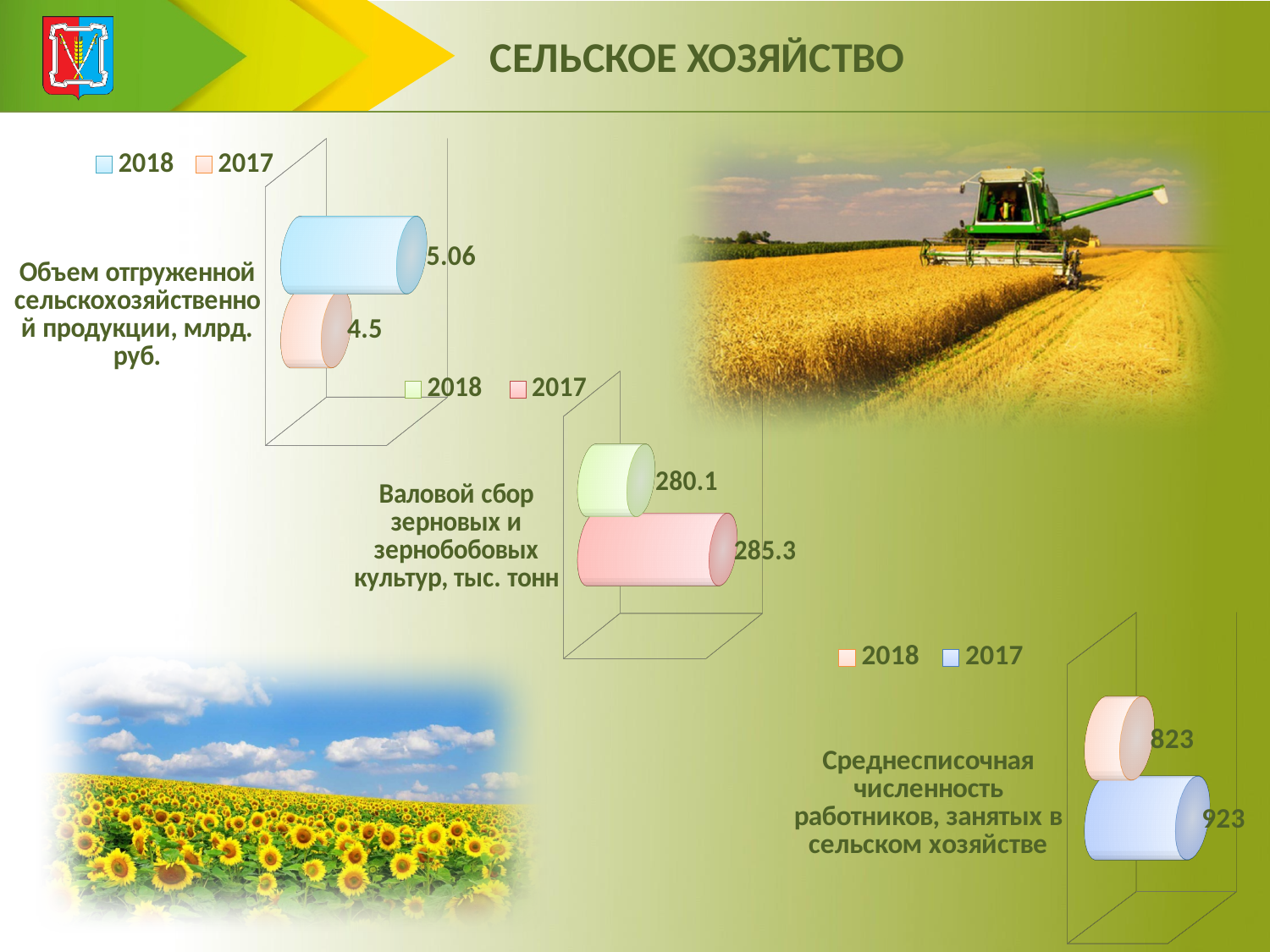
In the chart 'Среднесписочная численность работников, занятых в сельском хозяйстве' (bottom right), what is the difference between the 2017 and 2018 values? 100 In the chart 'Объем отгруженной сельскохозяйственной продукции, млрд. руб.' (top left), what is the value for 2018? 5.06 In the chart 'Валовой сбор зерновых и зернобобовых культур, тыс. тонн' (middle), what is the value for 2017? 285.3 In the chart 'Валовой сбор зерновых и зернобобовых культур, тыс. тонн' (middle), which year has the higher value? 2017 In the chart 'Объем отгруженной сельскохозяйственной продукции, млрд. руб.' (top left), what is the difference between the 2018 and 2017 values? 0.56 In the chart 'Объем отгруженной сельскохозяйственной продукции, млрд. руб.' (top left), which year has the larger value, 2018 or 2017? 2018 In the chart 'Среднесписочная численность работников, занятых в сельском хозяйстве' (bottom right), what is the value for 2017? 923 In the chart 'Валовой сбор зерновых и зернобобовых культур, тыс. тонн' (middle), what is the value for 2018? 280.1 In the chart 'Среднесписочная численность работников, занятых в сельском хозяйстве' (bottom right), what is the value for 2018? 823 How many series does the legend of the chart 'Среднесписочная численность работников, занятых в сельском хозяйстве' (bottom right) list? 2 In the chart 'Объем отгруженной сельскохозяйственной продукции, млрд. руб.' (top left), what is the value for 2017? 4.5 In the chart 'Валовой сбор зерновых и зернобобовых культур, тыс. тонн' (middle), what is the difference between the 2017 and 2018 values? 5.2